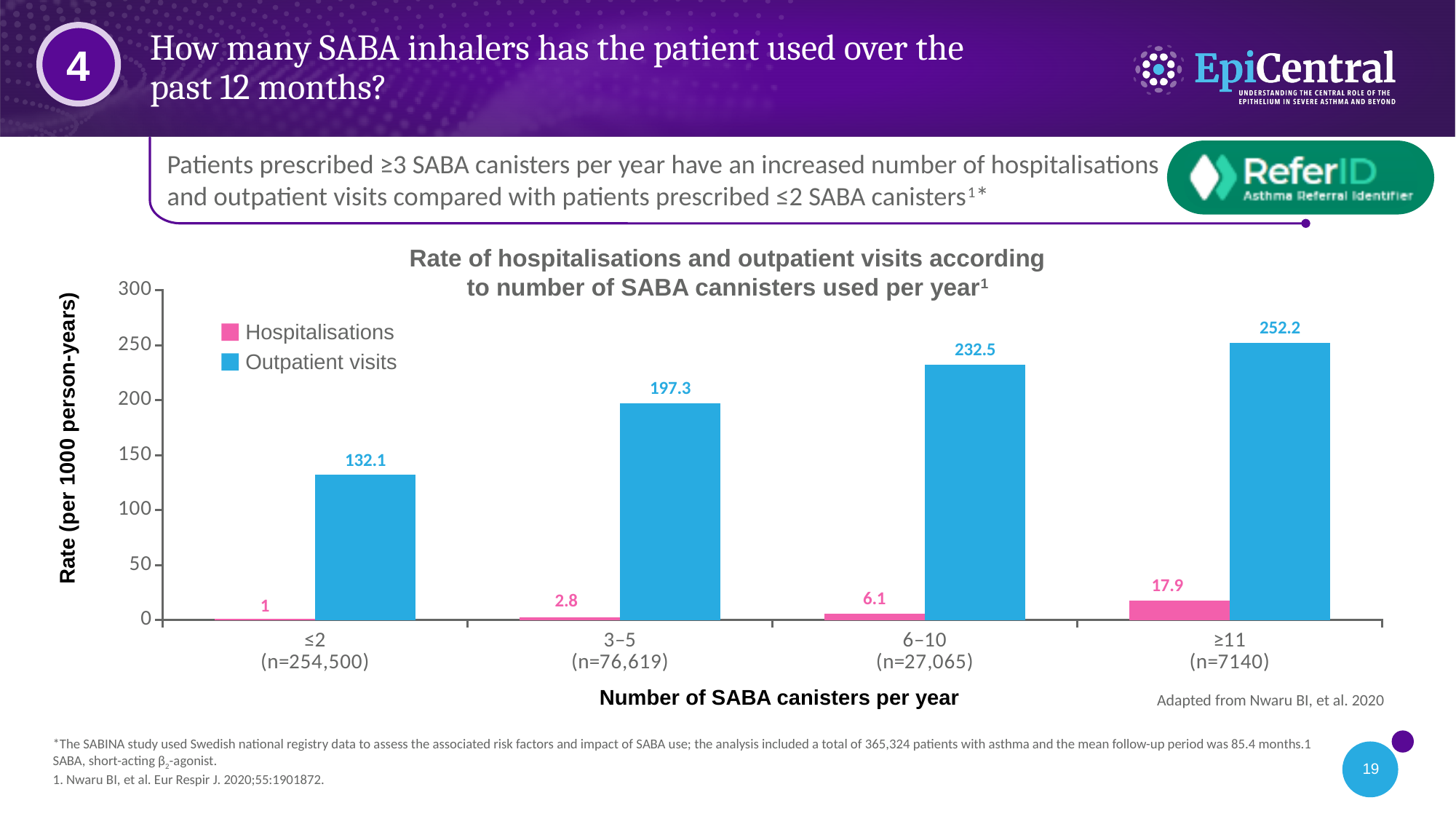
What is the rate of hospitalisations for patients using ≤2 SABA canisters per year? 1 Which is larger: the outpatient visit rate for 6–10 canisters or for 3–5 canisters? 6–10 canisters What is the rate of outpatient visits for patients using 3–5 SABA canisters per year? 197.3 Which SABA canister category has the highest rate of outpatient visits? ≥11 What is the difference in outpatient visit rate between the ≥11 and ≤2 canister categories? 120.1 Is the outpatient visit rate for the ≥11 canister category greater or less than 250? greater How many series does the legend list? 2 What is the rate of hospitalisations for patients using ≥11 SABA canisters per year? 17.9 What is the difference in hospitalisation rate between the 6–10 and 3–5 canister categories? 3.3 What kind of chart is shown on the slide? Bar chart How many SABA canister categories are shown on the x axis? 4 Which SABA canister category has the lowest rate of hospitalisations? ≤2